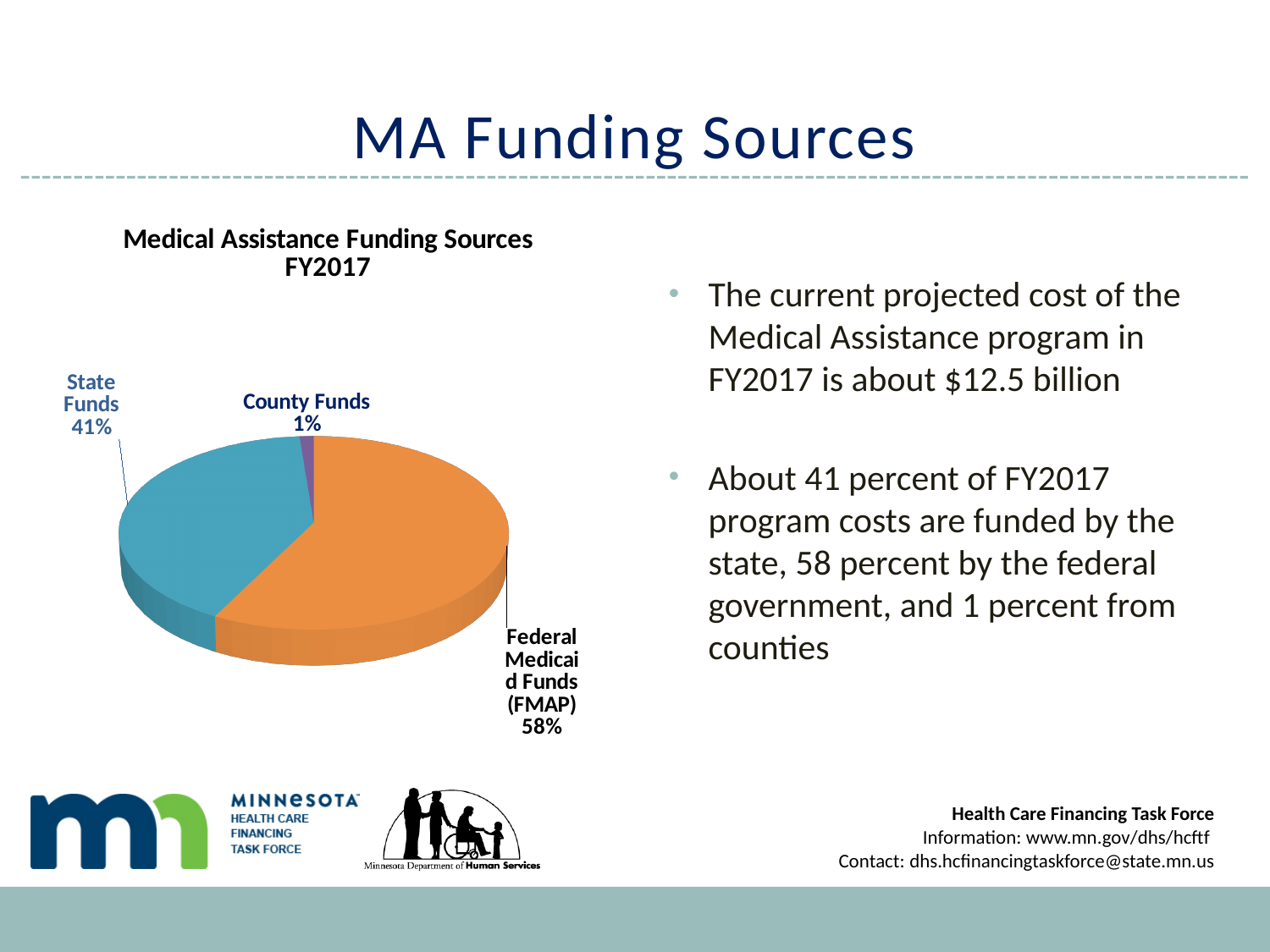
What share of the pie is State Funds? 41% What is the difference in percentage points between Federal Medicaid Funds (FMAP) and State Funds? 17 What is the title of the chart? Medical Assistance Funding Sources FY2017 How many slices does the pie chart have? 3 Which is larger, the share for State Funds or the share for County Funds? State Funds What share of the pie is Federal Medicaid Funds (FMAP)? 58% What share of the pie is County Funds? 1% Which funding source has the smallest share of the pie? County Funds What type of chart is shown on the slide? Pie chart What is the difference in percentage points between State Funds and County Funds? 40 Which funding source has the largest share of the pie? Federal Medicaid Funds (FMAP) What colour is the Federal Medicaid Funds (FMAP) slice? Orange